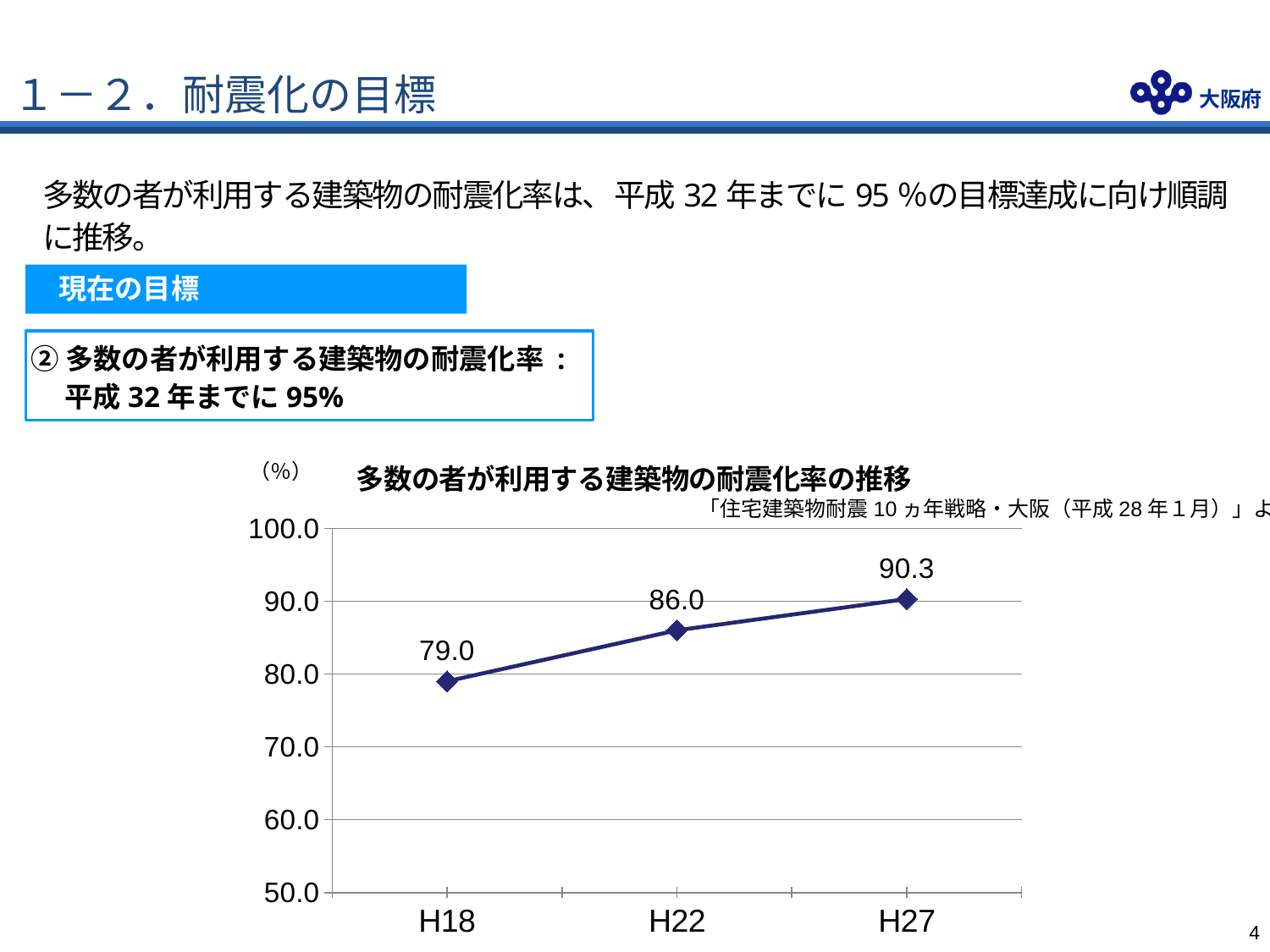
Which year has the lowest value? H18 What is the value for H27? 90.3 Which year has the highest value? H27 What is the difference between the values for H22 and H18? 7.0 Do the values rise or fall from H18 to H27? rise Which is larger, the value for H22 or the value for H27? H27 What is the value for H18? 79.0 Is the value for H27 greater or less than 90.0? greater What kind of chart is shown? line chart What is the difference between the values for H27 and H18? 11.3 What is the value for H22? 86.0 How many data points are plotted in the chart? 3